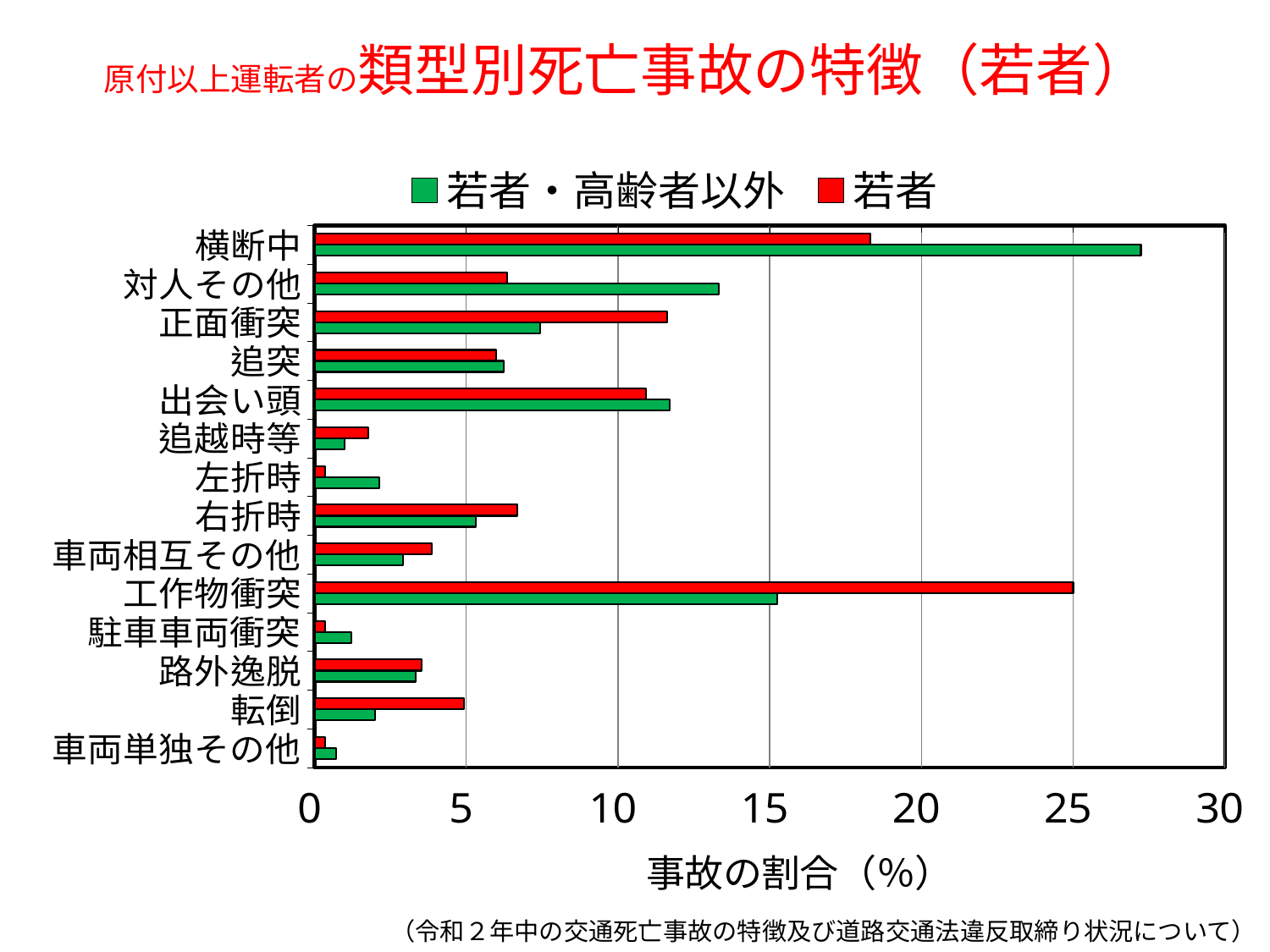
Which category has the highest value for the 若者 series? 工作物衝突 For 横断中, which series has the larger value, 若者 or 若者・高齢者以外? 若者・高齢者以外 Is the 若者 value for 横断中 greater or less than 20? less For 工作物衝突, which series has the larger value, 若者 or 若者・高齢者以外? 若者 Is the 若者 value for 正面衝突 greater or less than 10? greater How many accident-type categories are plotted on the y axis? 14 What is the label of the x axis? 事故の割合（%） Which category has the highest value for the 若者・高齢者以外 series? 横断中 What kind of chart is shown on the slide? bar chart Is the 若者・高齢者以外 value for 横断中 greater or less than 25? greater How many series does the legend list? 2